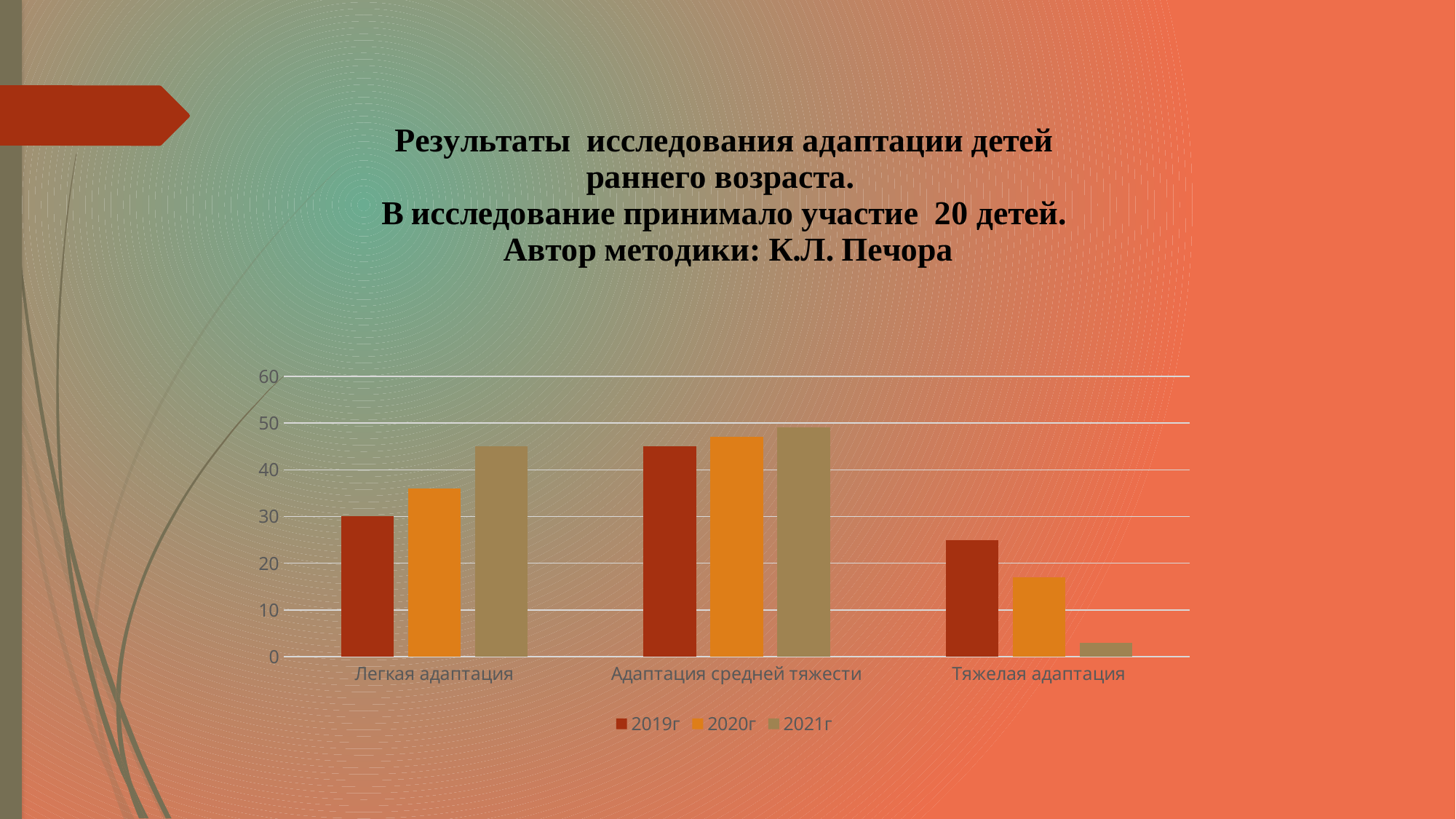
Is the value for 2021г in Тяжелая адаптация greater or less than 10? less How many categories are shown on the x axis? 3 Which series has the highest value for Тяжелая адаптация? 2019г For Легкая адаптация, which is larger: the value for 2019г or for 2021г? 2021г How many series does the legend list? 3 Do the values for Тяжелая адаптация rise or fall from 2019г to 2021г? fall Is the value for 2020г in Легкая адаптация greater or less than 30? greater What are the entries listed in the legend? 2019г, 2020г, 2021г What kind of chart is shown on the slide? bar chart Which series has the lowest value for Тяжелая адаптация? 2021г Which series has the highest value for Легкая адаптация? 2021г